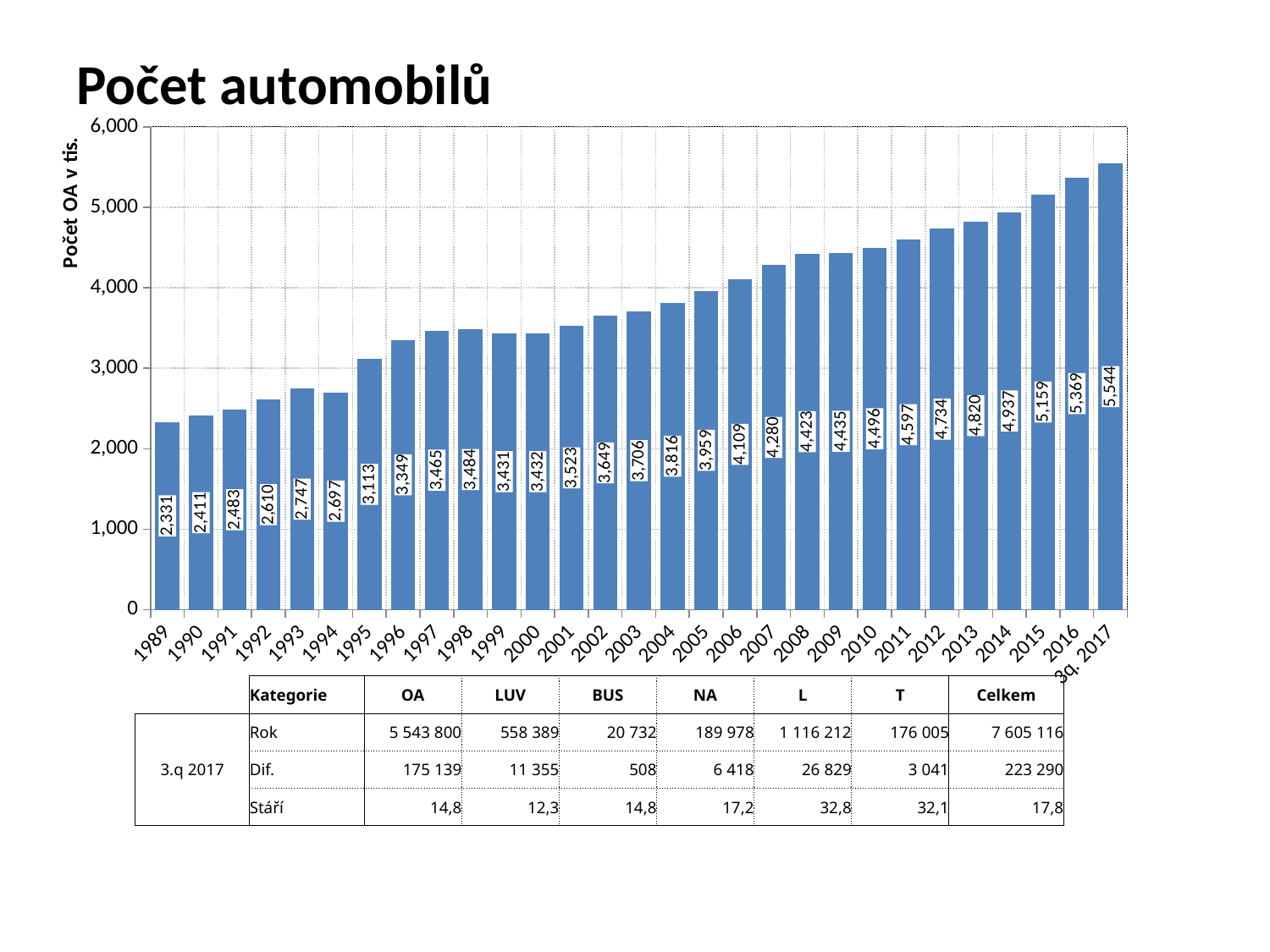
Is the value for 2007 greater or less than 4,000? greater Which is larger, the value for 1993 or the value for 1994? 1993 What is the difference between the values for 2016 and 2015? 210 How many bars are plotted in the chart? 29 Do the values generally rise or fall from 1989 to 3q. 2017? rise What is the value for 1989? 2,331 What kind of chart is shown? bar chart What is the value for 3q. 2017? 5,544 What is the value for 2005? 3,959 Which year has the lowest value? 1989 Which year has the highest value? 3q. 2017 What is the title of the chart's vertical axis? Počet OA v tis.